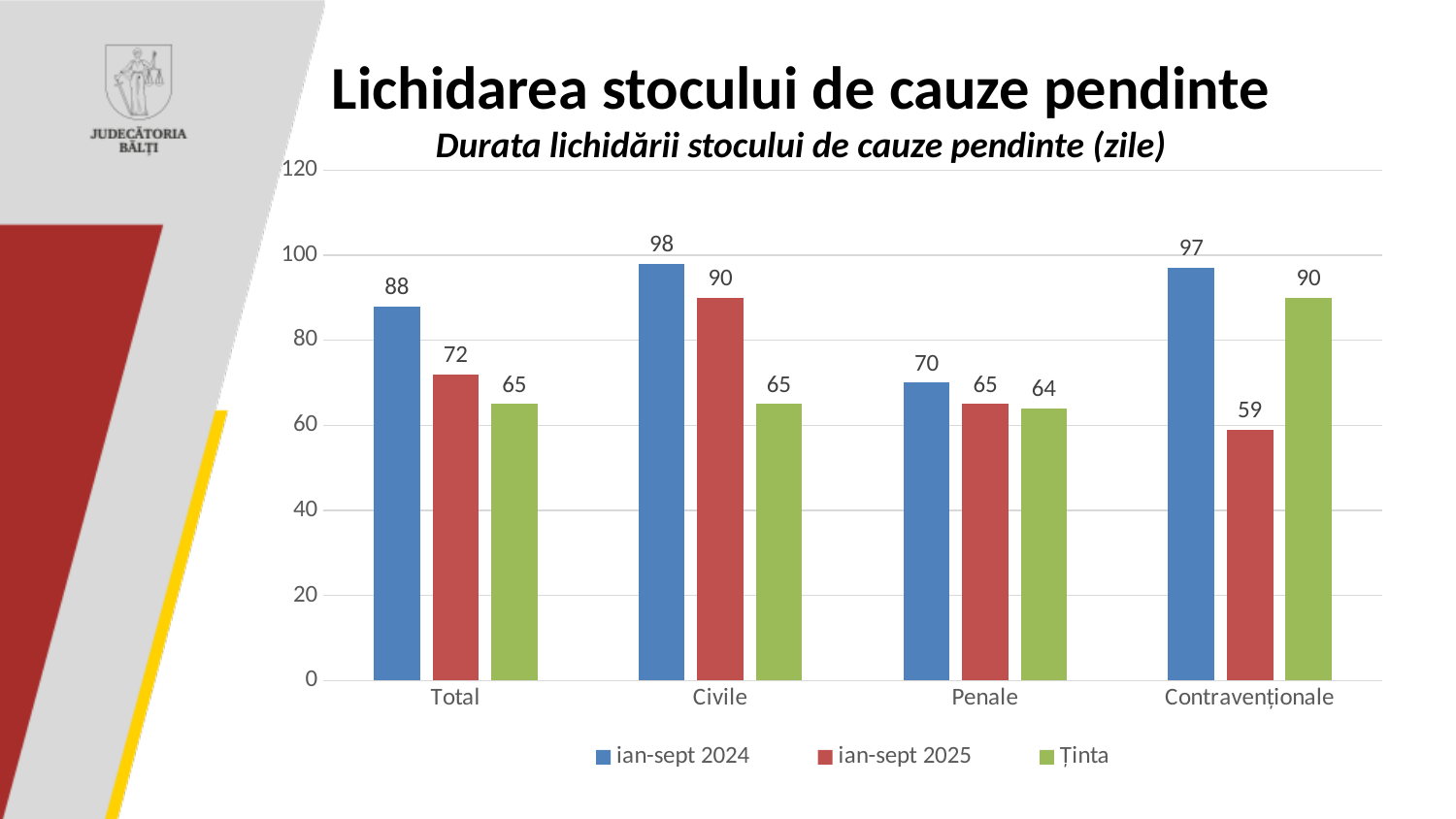
What is the difference between the ian-sept 2024 and ian-sept 2025 values for Total? 16 What is the value for Civile in the ian-sept 2024 series? 98 What is the subtitle of the chart? Durata lichidării stocului de cauze pendinte (zile) Which category has the highest value in the ian-sept 2024 series? Civile What is the value for Contravenționale in the ian-sept 2025 series? 59 Which category has the lowest value in the ian-sept 2025 series? Contravenționale Which is larger for Contravenționale: the ian-sept 2025 value or the Ținta value? Ținta Is the ian-sept 2024 value for Penale greater or less than 80? less How many series does the legend list? 3 What kind of chart is shown on the slide? bar chart What is the Ținta value for Penale? 64 How many categories are shown on the x axis? 4